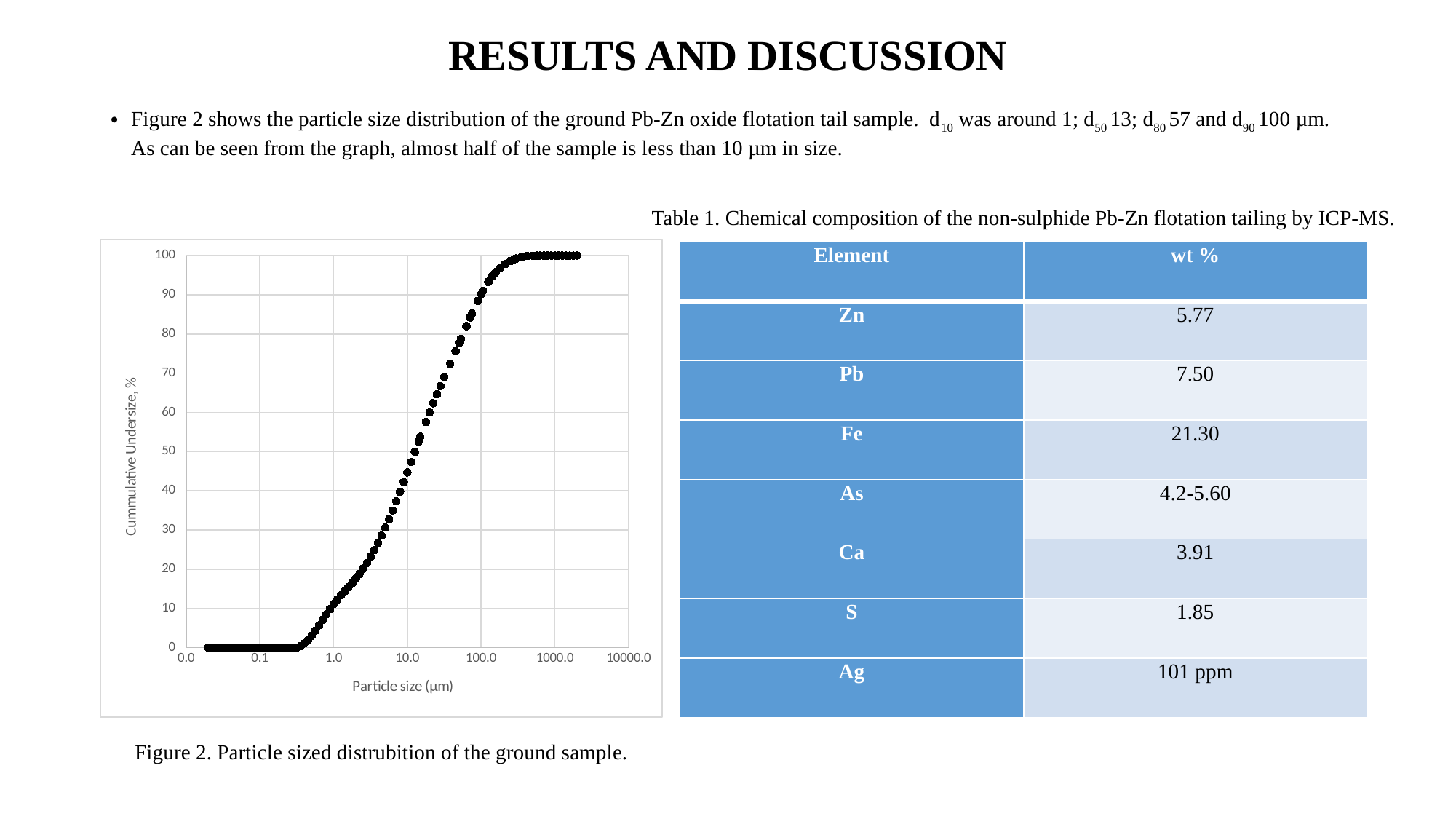
In Figure 2, is the cumulative undersize at a particle size of 0.1 µm greater or less than 10%? less In Figure 2, is the cumulative undersize at a particle size of 10.0 µm greater or less than 70%? less In Figure 2, does the cumulative undersize rise or fall as particle size increases along the x axis? rise What is the highest tick value shown on the y axis of Figure 2? 100 In Figure 2, is the cumulative undersize at a particle size of 100.0 µm greater or less than 70%? greater What is the label of the x axis in Figure 2? Particle size (µm) What kind of chart is shown in Figure 2? scatter chart What is the label of the y axis in Figure 2? Cummulative Undersize, %